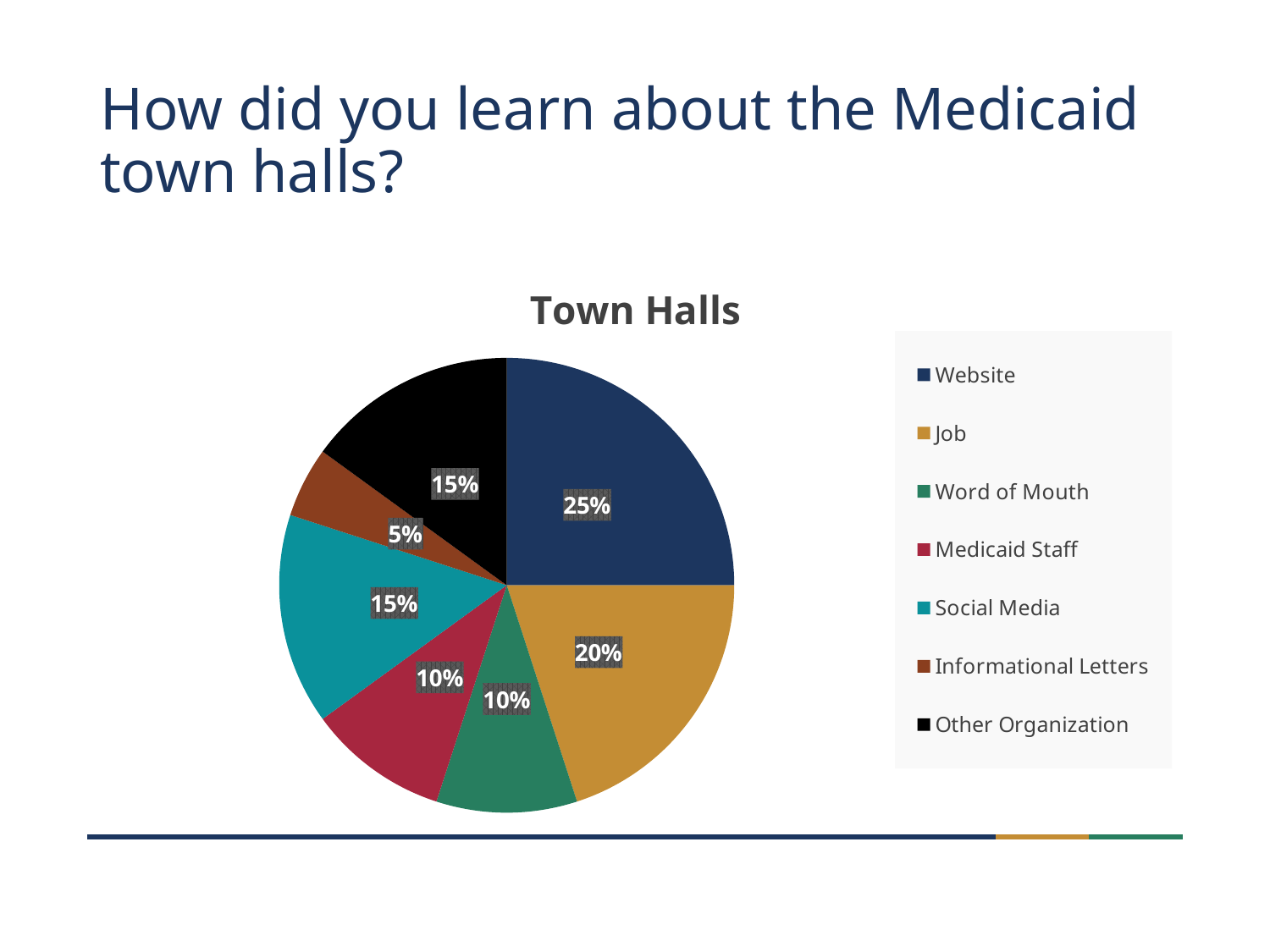
Which is larger, the share for Social Media or the share for Medicaid Staff? Social Media What percentage is shown for Informational Letters? 5% What percentage is shown for Social Media? 15% What colour is the slice for Other Organization? black What share of the pie is Job? 20% What percentage of respondents learned about the town halls from the Website? 25% Which category has the smallest slice of the pie? Informational Letters Which category has the largest slice of the pie? Website How many categories does the legend list? 7 What is the difference in percentage points between Website and Job? 5 What kind of chart is shown on the slide? pie chart What is the title of the chart? Town Halls